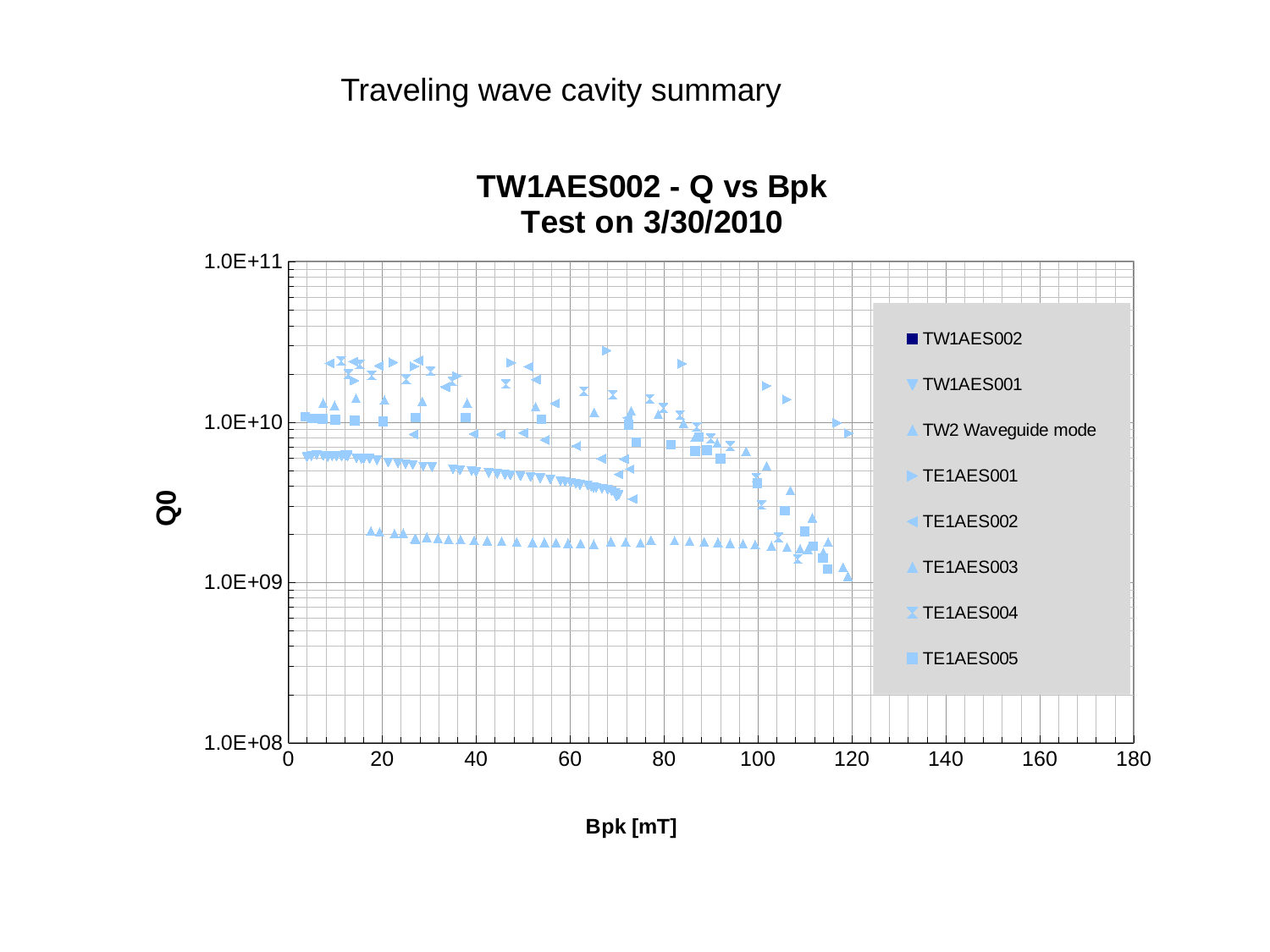
Do the values of the TW1AES001 series rise or fall as Bpk increases? fall Are the values of the TW1AES001 series greater or less than 1.0E+10? less Are all plotted values greater or less than 1.0E+11? less What kind of chart is shown on the slide? scatter chart What is the label of the x axis? Bpk [mT] How many series does the legend list? 8 What is the title of the chart? TW1AES002 - Q vs Bpk Test on 3/30/2010 Are all plotted values greater or less than 1.0E+08? greater